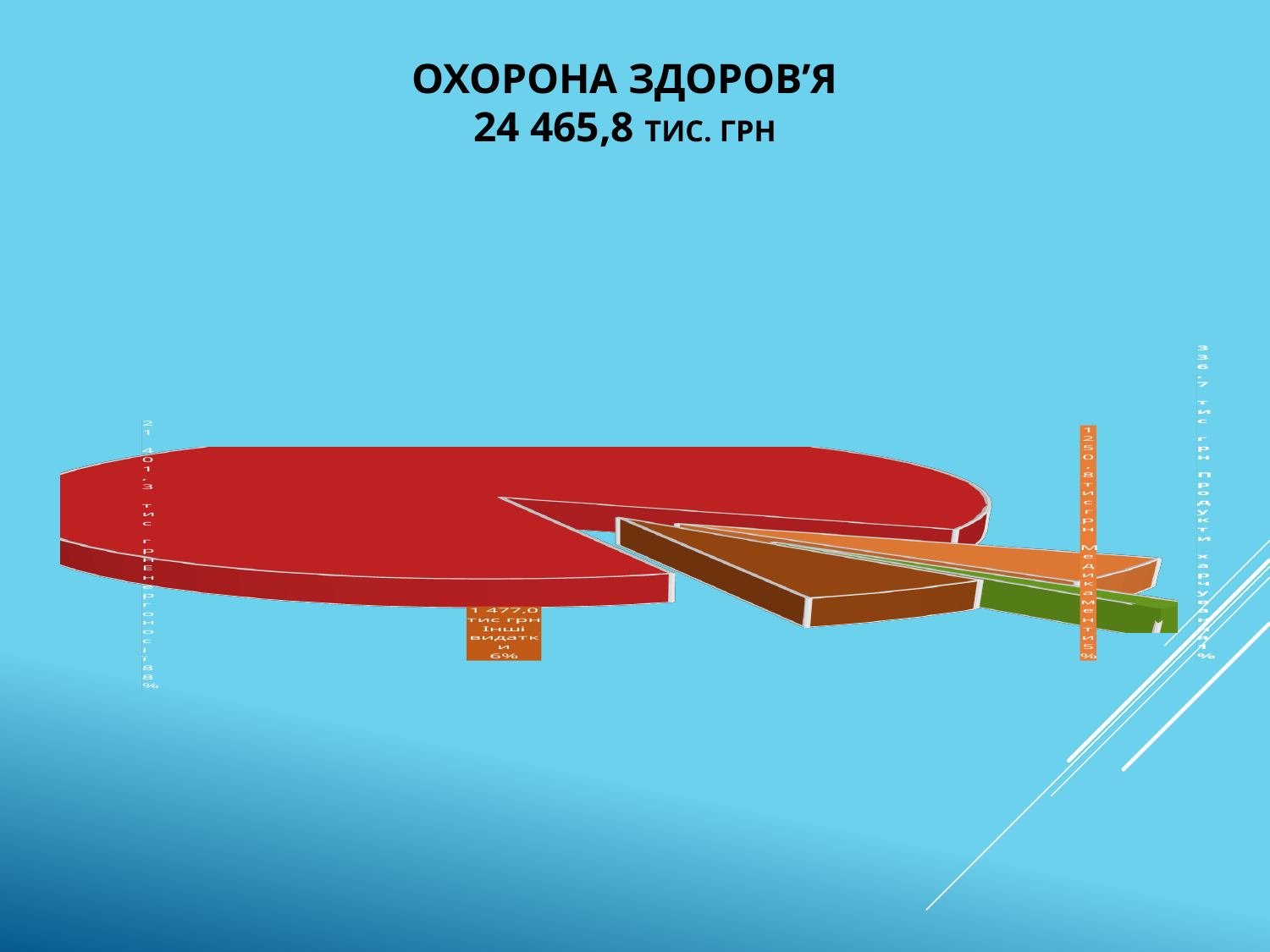
What share of the pie does Енергоносії take? 88% What is the value shown for Медикаменти? 1 250,8 тис грн Which category has the largest slice of the pie? Енергоносії Which category has the smallest slice of the pie? Продукти харчування What total amount is stated in the chart title? 24 465,8 тис. грн Which is larger, Інші видатки or Медикаменти? Інші видатки What kind of chart is shown on the slide? pie chart What is the value shown for Енергоносії? 21 401,3 тис грн What share of the pie does Медикаменти take? 5% How many slices does the pie chart have? 4 What is the value shown for Продукти харчування? 336,7 тис грн What is the value shown for Інші видатки? 1 477,0 тис грн